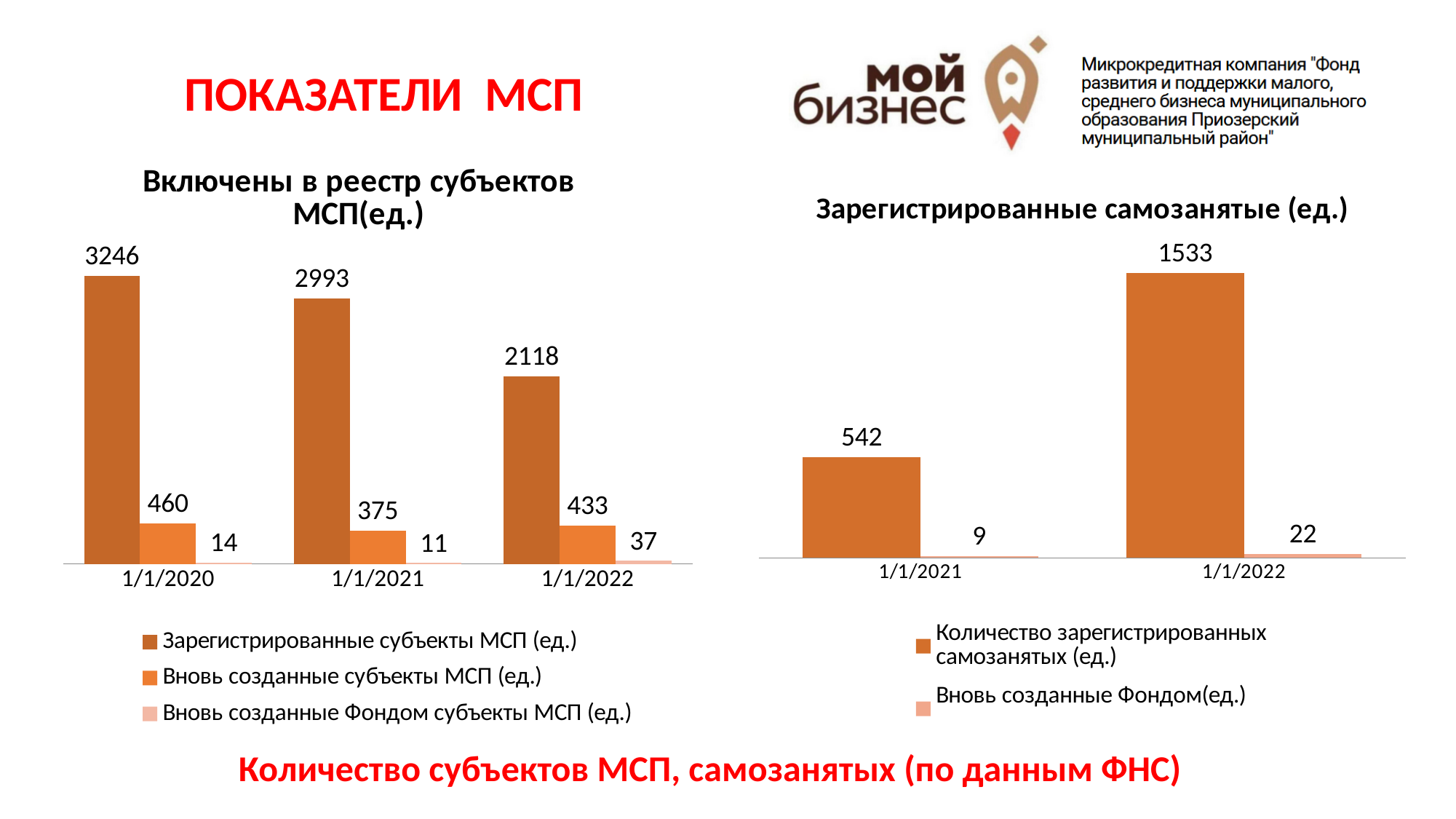
How many dates are shown on the x axis of the chart 'Зарегистрированные самозанятые (ед.)'? 2 In the chart 'Включены в реестр субъектов МСП(ед.)', does the value of 'Зарегистрированные субъекты МСП (ед.)' rise or fall from 1/1/2020 to 1/1/2022? fall How many series does the legend of the chart 'Включены в реестр субъектов МСП(ед.)' list? 3 In the chart 'Зарегистрированные самозанятые (ед.)', what is the value of 'Вновь созданные Фондом(ед.)' for 1/1/2021? 9 In the chart 'Включены в реестр субъектов МСП(ед.)', what is the difference between the 'Зарегистрированные субъекты МСП (ед.)' values for 1/1/2020 and 1/1/2021? 253 What type of chart is 'Зарегистрированные самозанятые (ед.)'? bar chart In the chart 'Зарегистрированные самозанятые (ед.)', what is the difference between the 'Количество зарегистрированных самозанятых (ед.)' values for 1/1/2022 and 1/1/2021? 991 In the chart 'Включены в реестр субъектов МСП(ед.)', what is the value of 'Зарегистрированные субъекты МСП (ед.)' for 1/1/2020? 3246 In the chart 'Включены в реестр субъектов МСП(ед.)', what is the value of 'Вновь созданные Фондом субъекты МСП (ед.)' for 1/1/2022? 37 In the chart 'Включены в реестр субъектов МСП(ед.)', what is the value of 'Вновь созданные субъекты МСП (ед.)' for 1/1/2021? 375 In the chart 'Включены в реестр субъектов МСП(ед.)', which date has the lowest value for 'Зарегистрированные субъекты МСП (ед.)'? 1/1/2022 In the chart 'Зарегистрированные самозанятые (ед.)', what is the value of 'Количество зарегистрированных самозанятых (ед.)' for 1/1/2022? 1533